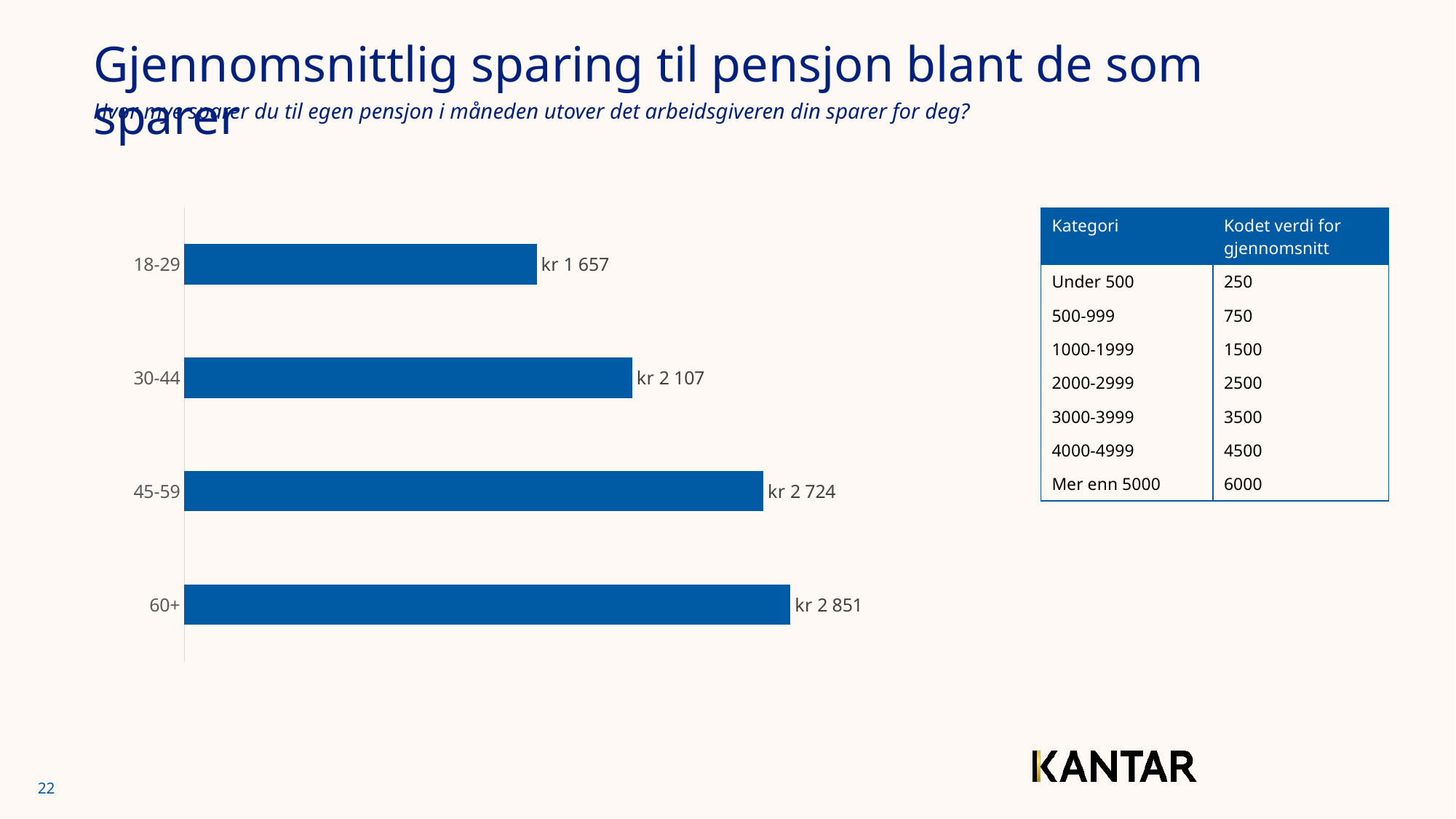
Do the values rise or fall as the age groups get older, from 18-29 to 60+? Rise What is the value for the 30-44 age group? kr 2 107 What kind of chart is shown on the slide? Bar chart What is the difference between the values for 45-59 and 30-44? kr 617 What is the difference between the values for 60+ and 18-29? kr 1 194 Which is larger, the value for 30-44 or the value for 45-59? 45-59 What is the value for the 45-59 age group? kr 2 724 Which age group has the highest average pension saving? 60+ How many age groups are shown in the chart? 4 What is the value for the 18-29 age group? kr 1 657 What is the value for the 60+ age group? kr 2 851 Which age group has the lowest average pension saving? 18-29